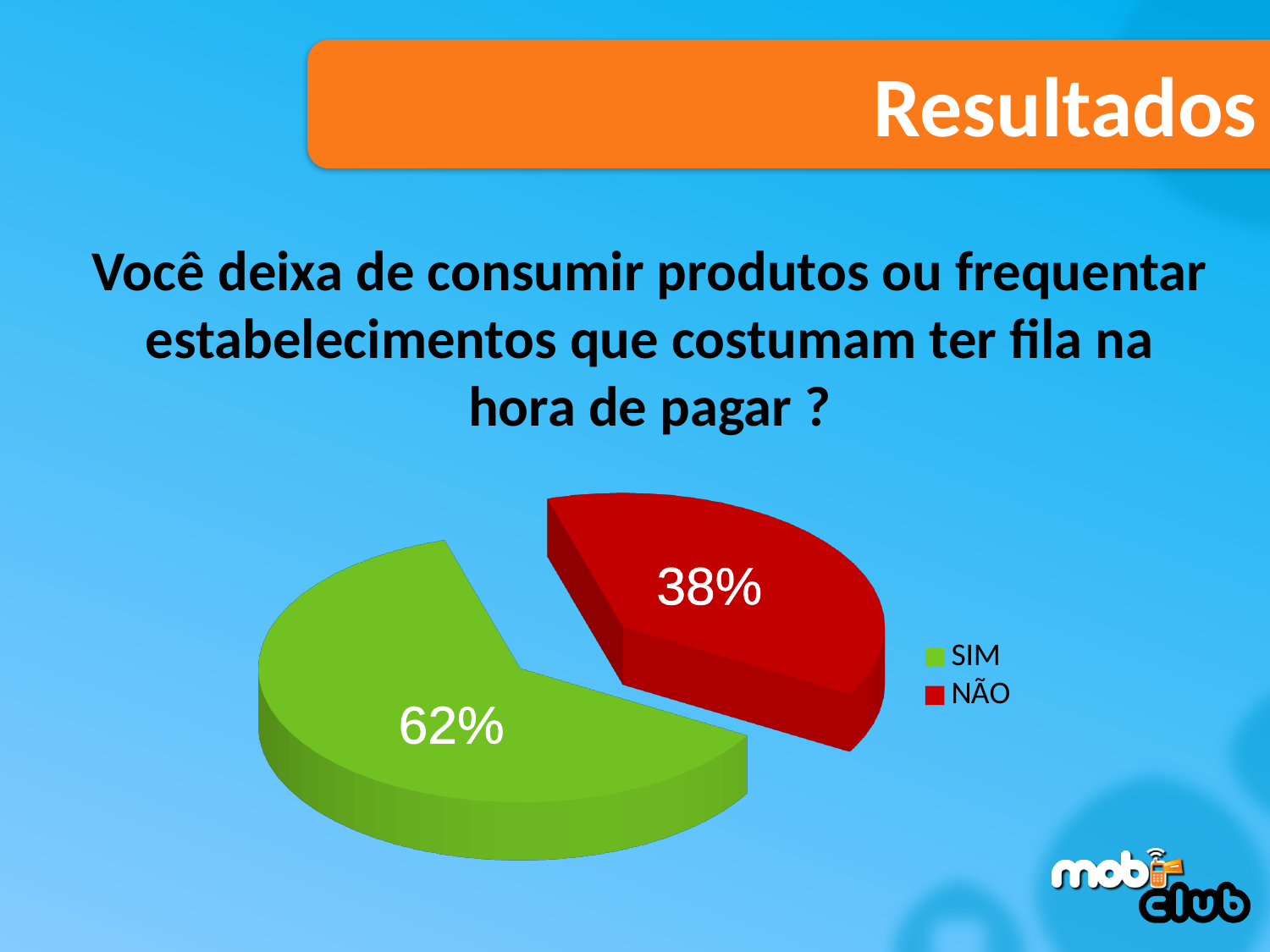
What share of the pie does the NÃO slice represent? 38% What colour is the NÃO slice? red What percentage of respondents answered NÃO? 38% What kind of chart is shown on the slide? pie chart How many entries does the legend list? 2 What is the difference in percentage points between the SIM and NÃO slices? 24 Which response has the smallest share of the pie? NÃO What colour is the SIM slice? green Which slice is larger, SIM or NÃO? SIM Which response has the largest share of the pie? SIM How many slices does the pie chart have? 2 What percentage of respondents answered SIM? 62%